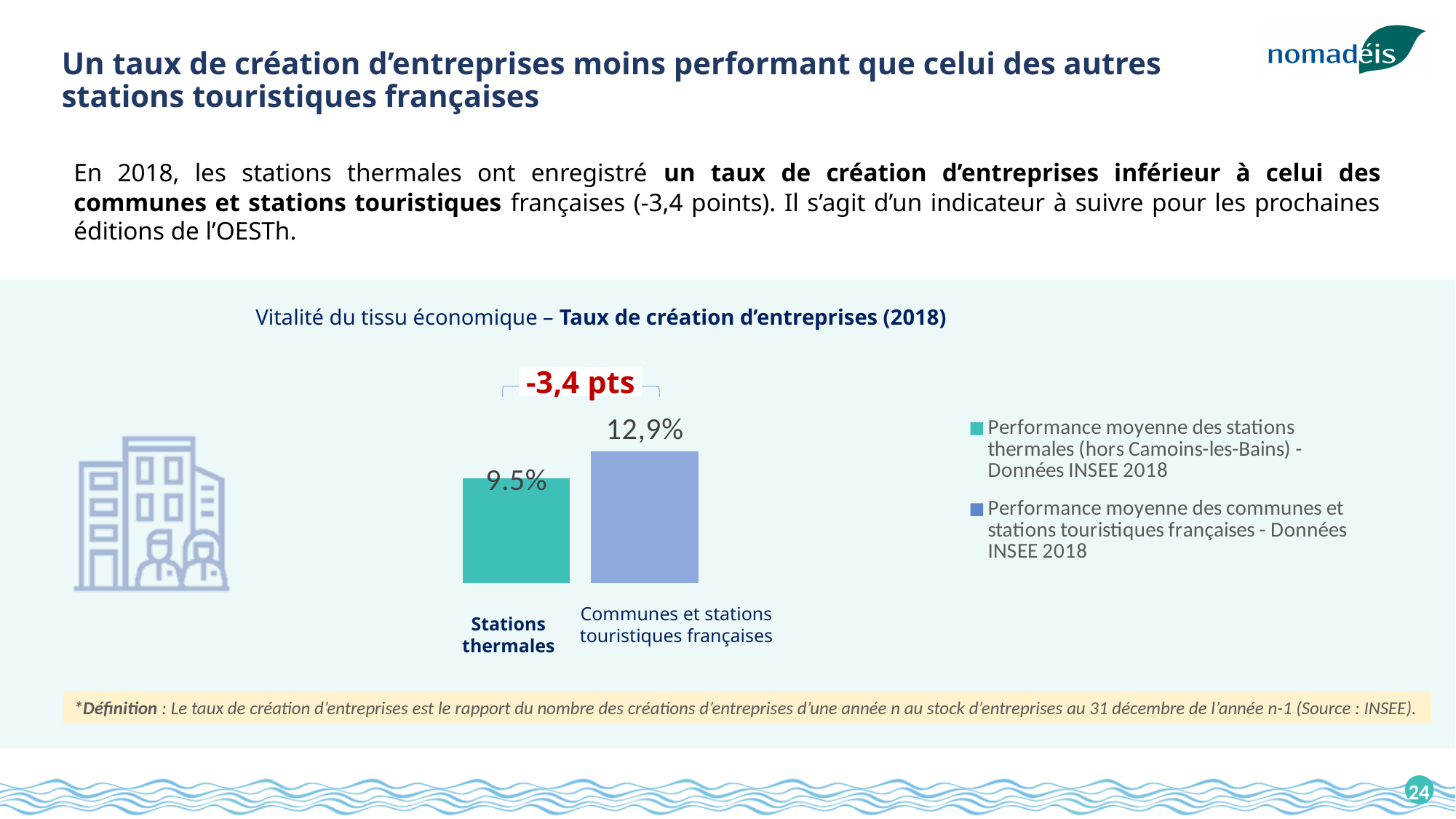
What colour is the bar for Stations thermales? teal/green How many bars are plotted in the chart? 2 What is the difference in points between the two bars, as labelled on the chart? -3,4 pts Which data source year is cited in the legend entries? INSEE 2018 What is the title of the chart? Vitalité du tissu économique – Taux de création d'entreprises (2018) What type of chart is shown on the slide? bar chart Which category has the lower taux de création d'entreprises? Stations thermales What is the value shown for Communes et stations touristiques françaises? 12,9% Which category has the higher taux de création d'entreprises? Communes et stations touristiques françaises What is the value shown for Stations thermales? 9.5% Is the value for Stations thermales larger or smaller than the value for Communes et stations touristiques françaises? smaller How many entries does the chart legend list? 2